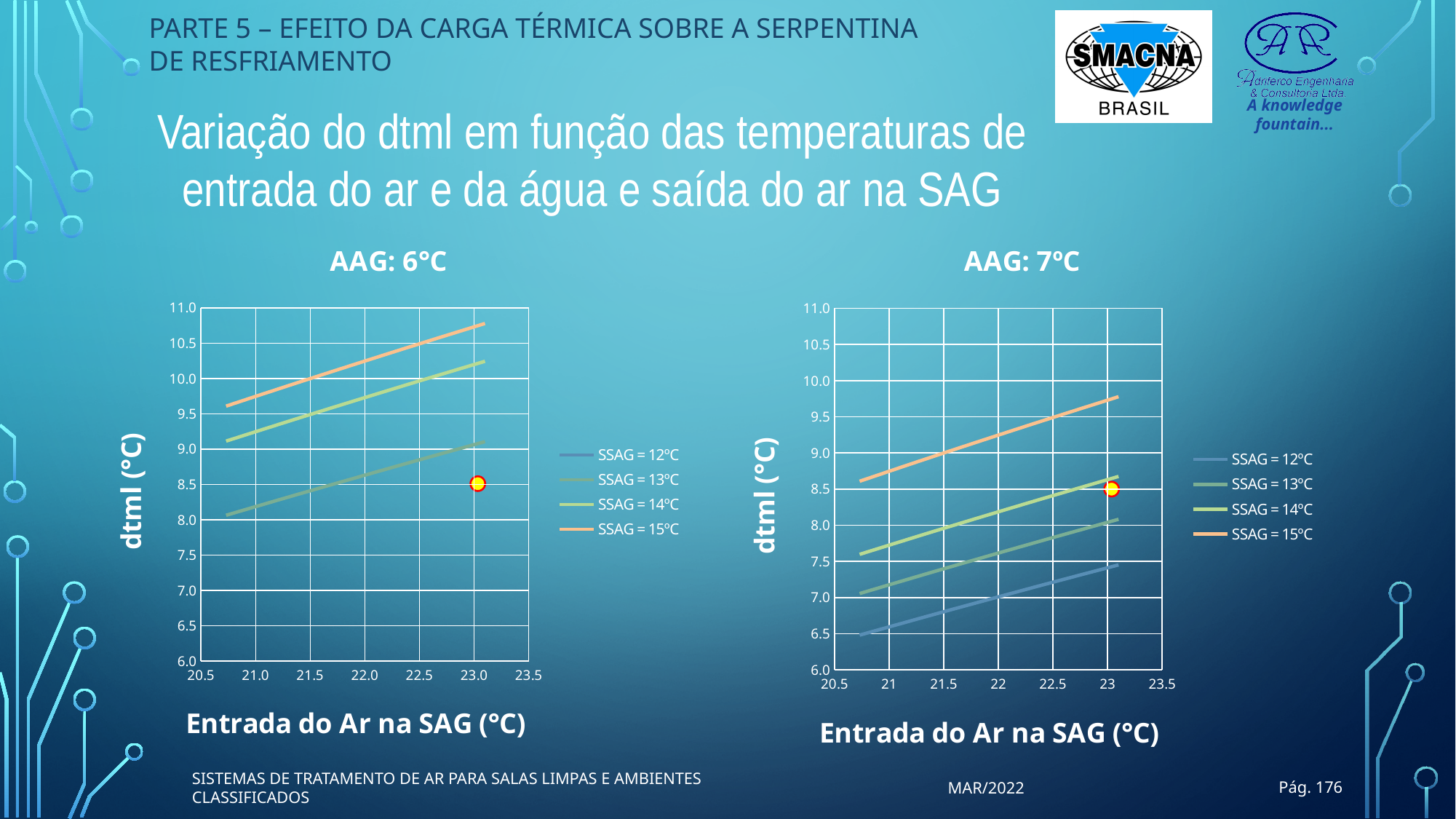
In the 'AAG: 7°C' chart, which series has higher dtml values, SSAG = 12°C or SSAG = 13°C? SSAG = 13°C How many series does the legend of the 'AAG: 7°C' chart list? 4 In the 'AAG: 6°C' chart, is the dtml value for SSAG = 15°C at an air inlet temperature of 23 greater or less than 10.5? greater In the 'AAG: 7°C' chart, which series has the highest dtml values? SSAG = 15°C In the 'AAG: 6°C' chart, do the dtml values rise or fall as the air inlet temperature increases along the x axis? rise In the 'AAG: 6°C' chart, which series has higher dtml values, SSAG = 14°C or SSAG = 13°C? SSAG = 14°C In the 'AAG: 7°C' chart, is the dtml value for SSAG = 15°C at an air inlet temperature of 23 greater or less than 9.5? greater In the 'AAG: 7°C' chart, is the dtml value for SSAG = 12°C at an air inlet temperature of 21 greater or less than 7.0? less What is the label of the x axis on the 'AAG: 7°C' chart? Entrada do Ar na SAG (°C) What is the label of the y axis on the 'AAG: 6°C' chart? dtml (°C) What kind of chart is the 'AAG: 6°C' chart? line chart In the 'AAG: 7°C' chart, which series has the lowest dtml values? SSAG = 12°C